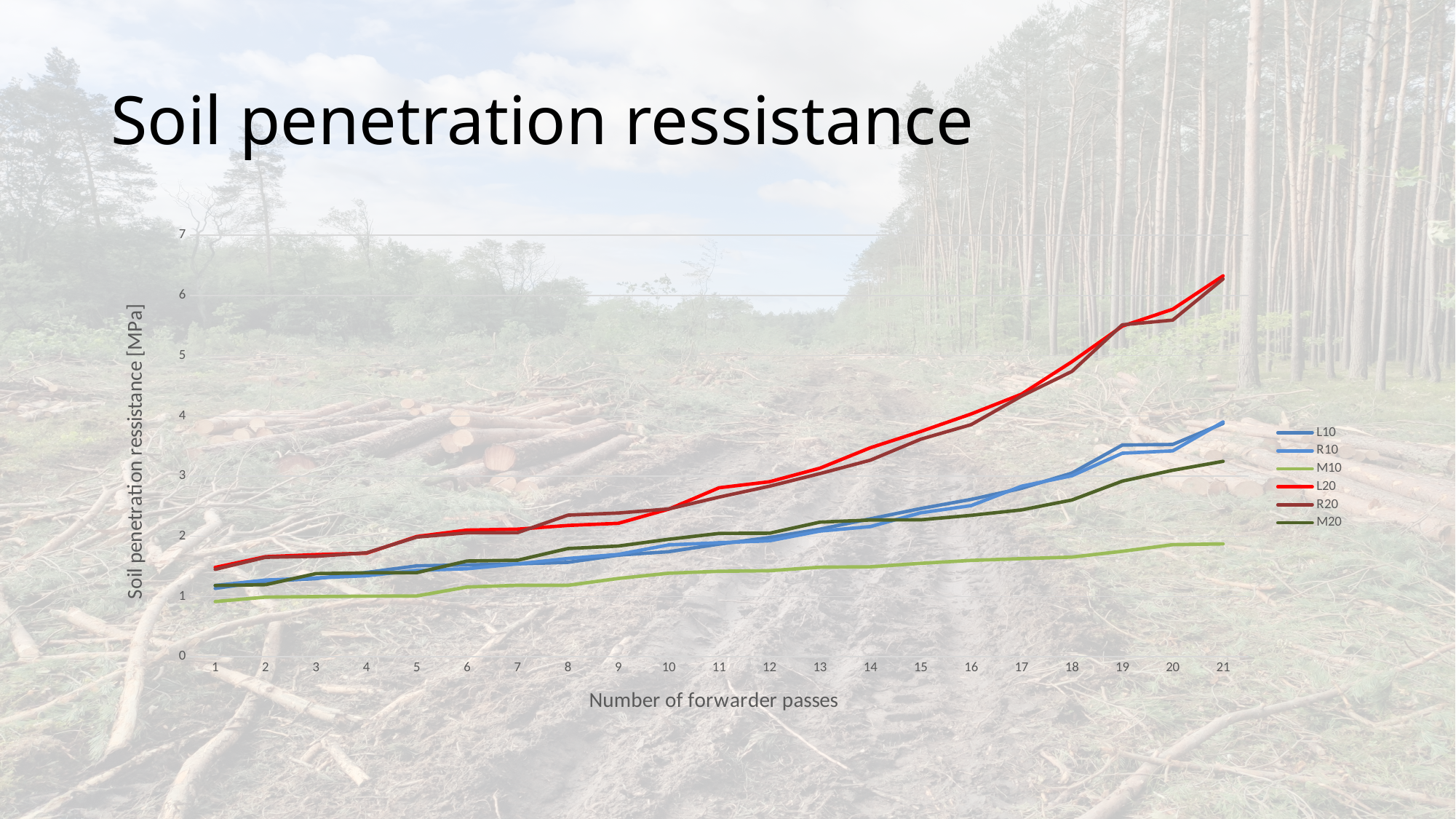
Is the value for L20 at 21 forwarder passes greater or less than 6? greater Is the value for L10 at 21 forwarder passes greater or less than 3? greater Is the value for M20 at 21 forwarder passes greater or less than 4? less Which series has the lowest value at 21 forwarder passes? M10 How many series does the legend list? 6 What is the title of the x axis? Number of forwarder passes At 10 forwarder passes, which series has the higher value, L20 or M10? L20 Do the values for the L20 series rise or fall as the number of forwarder passes increases? rise How many forwarder passes are marked along the x axis? 21 What kind of chart is shown on the slide? line chart At 21 forwarder passes, which series has the higher value, L20 or M20? L20